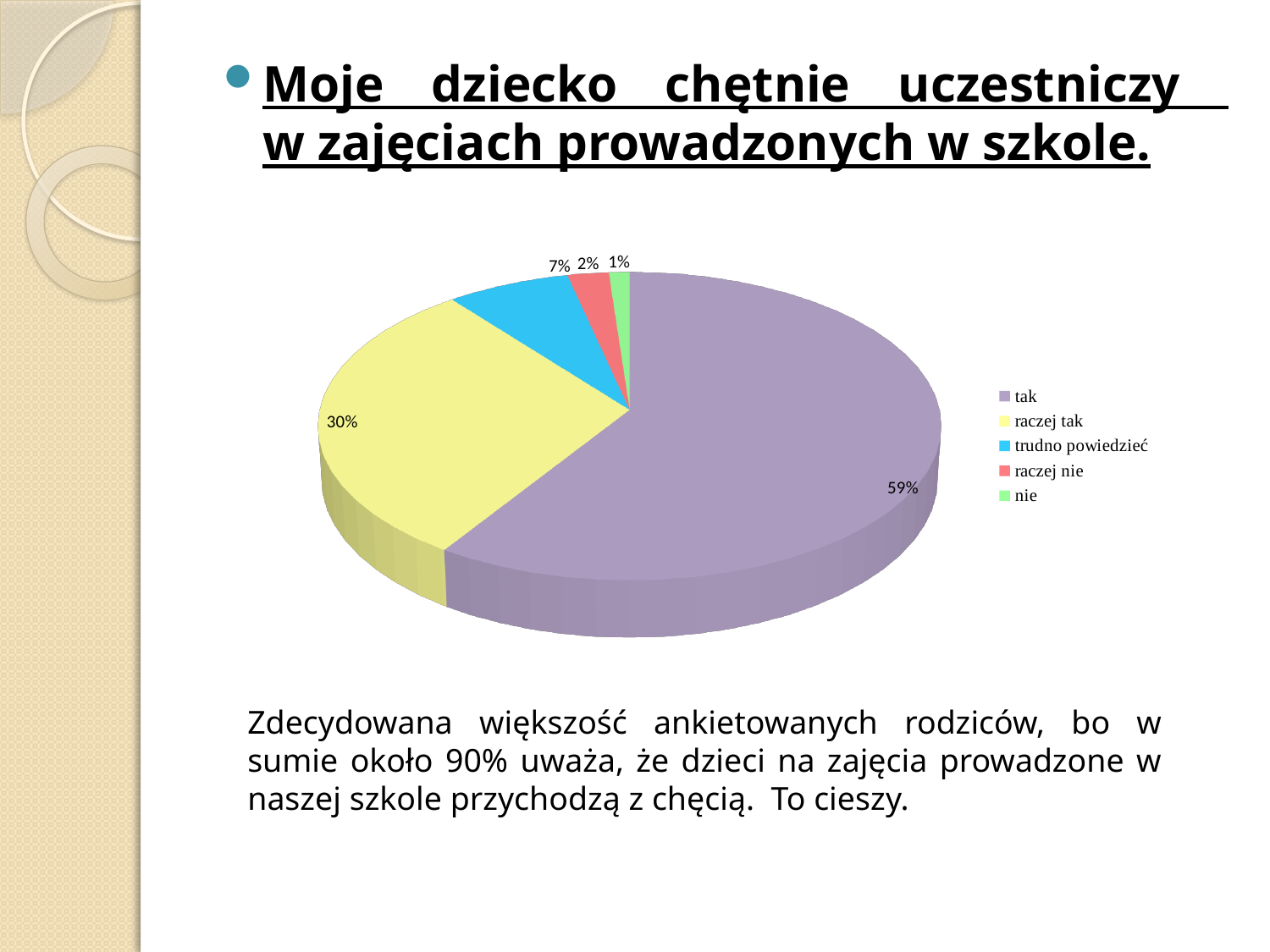
Which answer has the smallest share of the pie? nie What percentage of respondents answered "trudno powiedzieć"? 7% What percentage of respondents answered "raczej tak"? 30% What percentage of respondents answered "raczej nie"? 2% What is the difference in percentage points between "tak" and "raczej tak"? 29 What colour is the slice for "raczej tak"? yellow Which answer has the largest share of the pie? tak How many categories does the legend list? 5 What percentage of respondents answered "tak"? 59% What percentage of respondents answered "nie"? 1% Which is larger, the share for "trudno powiedzieć" or the share for "raczej nie"? trudno powiedzieć What kind of chart is shown on the slide? pie chart